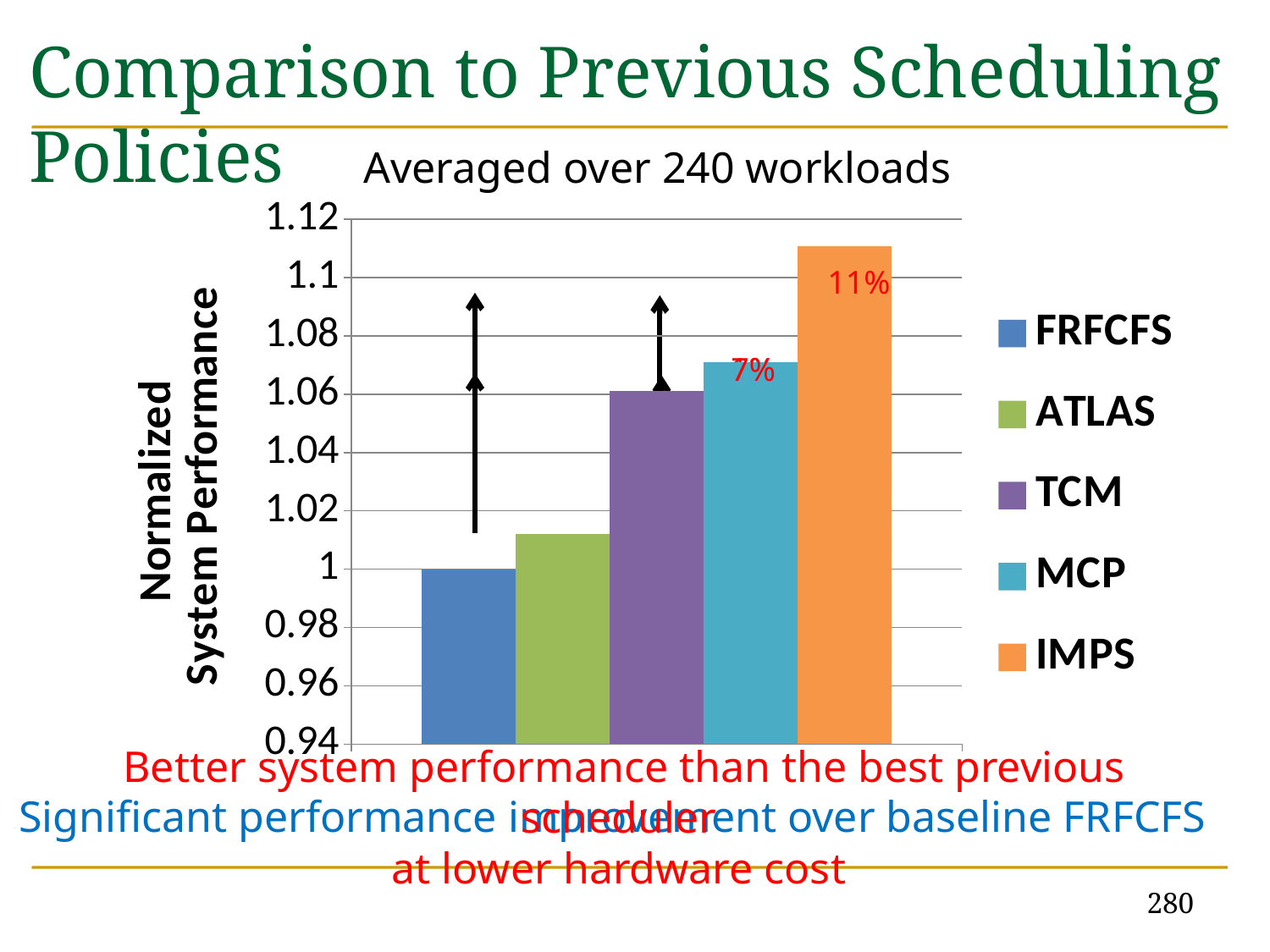
Which has higher normalized system performance, TCM or ATLAS? TCM Is the normalized system performance for MCP greater or less than 1.06? greater Is the normalized system performance for IMPS greater or less than 1.1? greater Which has higher normalized system performance, IMPS or MCP? IMPS Which scheduling policy has the highest normalized system performance? IMPS How many series does the legend list? 5 What is the title of the chart? Averaged over 240 workloads What kind of chart is shown on the slide? bar chart Is the normalized system performance for ATLAS greater or less than 1.02? less What is the normalized system performance of FRFCFS? 1 Which scheduling policy has the lowest normalized system performance? FRFCFS What is the label of the y axis? Normalized System Performance